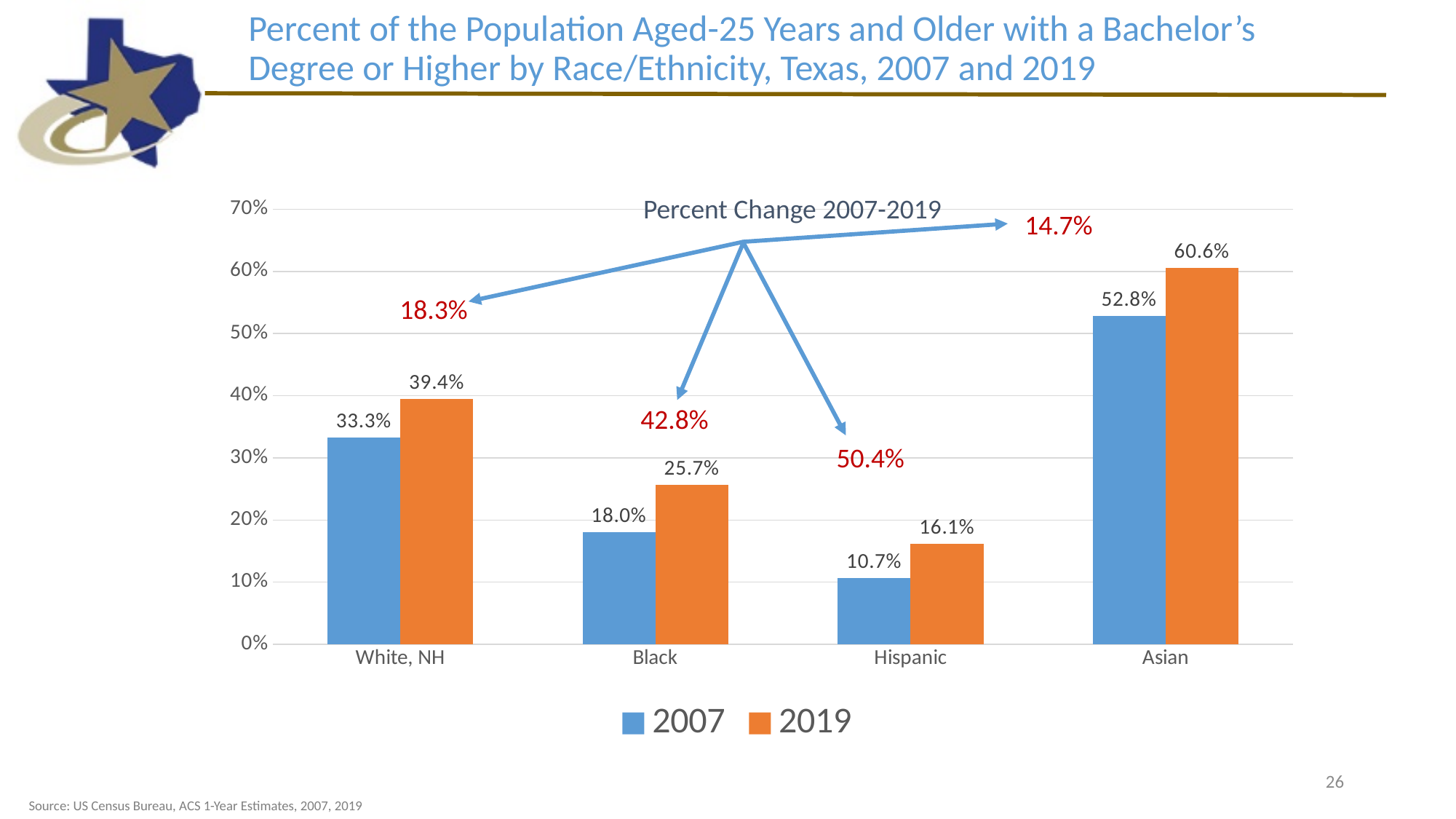
Which is larger: the 2007 value for White, NH or the 2019 value for Black? 2007 value for White, NH What is the difference between the 2019 and 2007 values for Black? 7.7 percentage points How many series does the legend list? 2 What percent change from 2007 to 2019 is annotated for the Hispanic group? 50.4% Which race/ethnicity group had the highest percentage in 2019? Asian What was the value for Hispanic in 2007? 10.7% What was the percent of the White, NH population aged 25 and older with a bachelor's degree or higher in 2019? 39.4% Is the 2019 value for Hispanic greater or less than 20%? less What was the value for Asian in 2019? 60.6% Which race/ethnicity group had the lowest percentage in 2007? Hispanic What kind of chart is shown on the slide? Bar chart How many race/ethnicity categories are shown on the x axis? 4